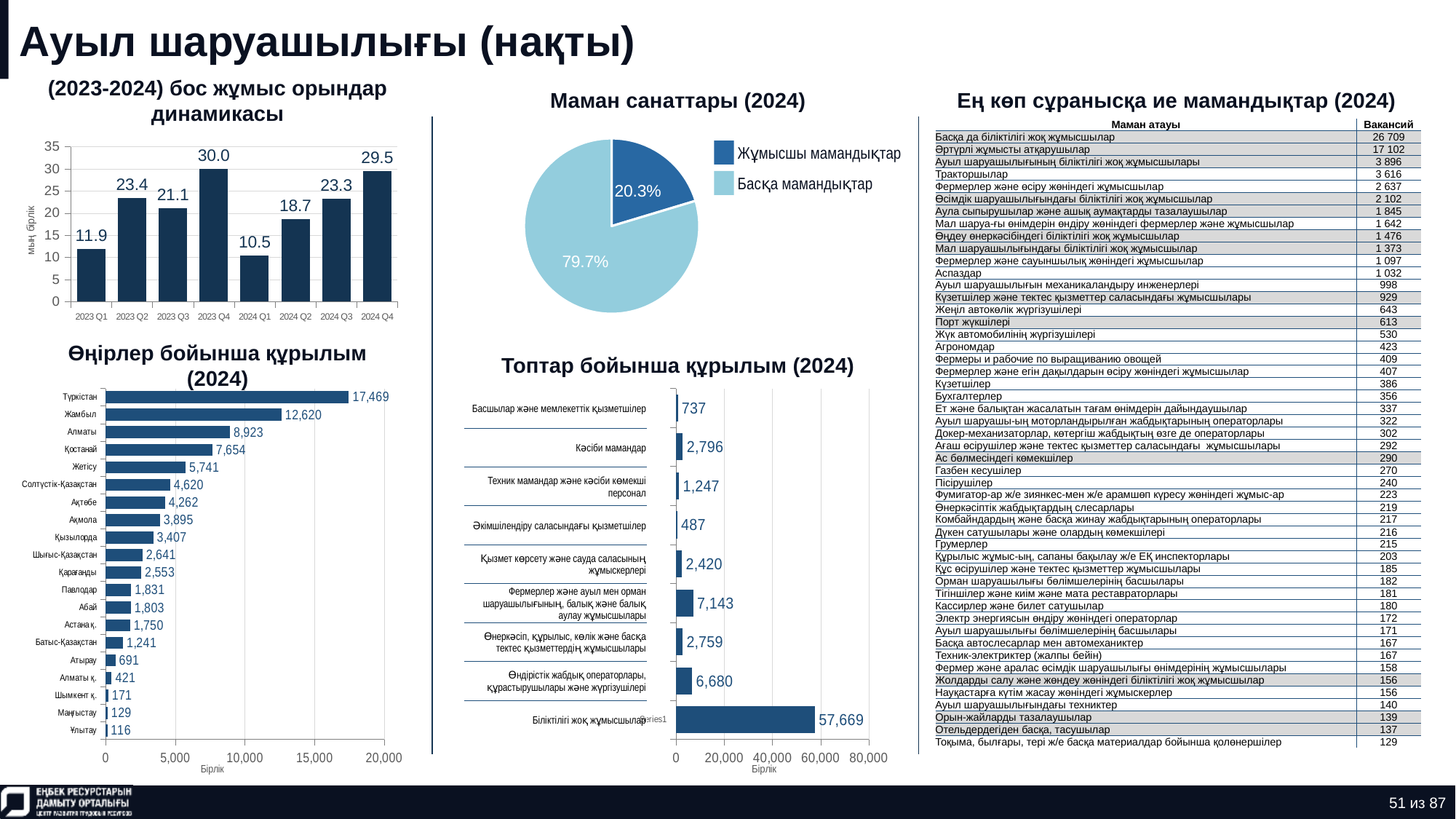
In the chart "Өңірлер бойынша құрылым (2024)", which is larger, the value for Жетісу or the value for Ақтөбе? Жетісу In the pie chart "Маман санаттары (2024)", what share does "Басқа мамандықтар" have? 79.7% In the pie chart "Маман санаттары (2024)", how many entries does the legend list? 2 In the chart "Өңірлер бойынша құрылым (2024)", what kind of chart is shown? bar chart In the chart "Топтар бойынша құрылым (2024)", what is the value for "Кәсіби мамандар"? 2,796 In the chart "Өңірлер бойынша құрылым (2024)", what is the value for Алматы? 8,923 In the chart "Өңірлер бойынша құрылым (2024)", which region has the highest value? Түркістан In the chart "(2023-2024) бос жұмыс орындар динамикасы", what is the difference between the values for 2024 Q4 and 2024 Q3? 6.2 In the chart "(2023-2024) бос жұмыс орындар динамикасы", what is the value for 2023 Q4? 30.0 In the chart "(2023-2024) бос жұмыс орындар динамикасы", which quarter has the lowest value? 2024 Q1 In the chart "Топтар бойынша құрылым (2024)", which category has the lowest value? Әкімшілендіру саласындағы қызметшілер In the chart "(2023-2024) бос жұмыс орындар динамикасы", how many quarters are plotted? 8